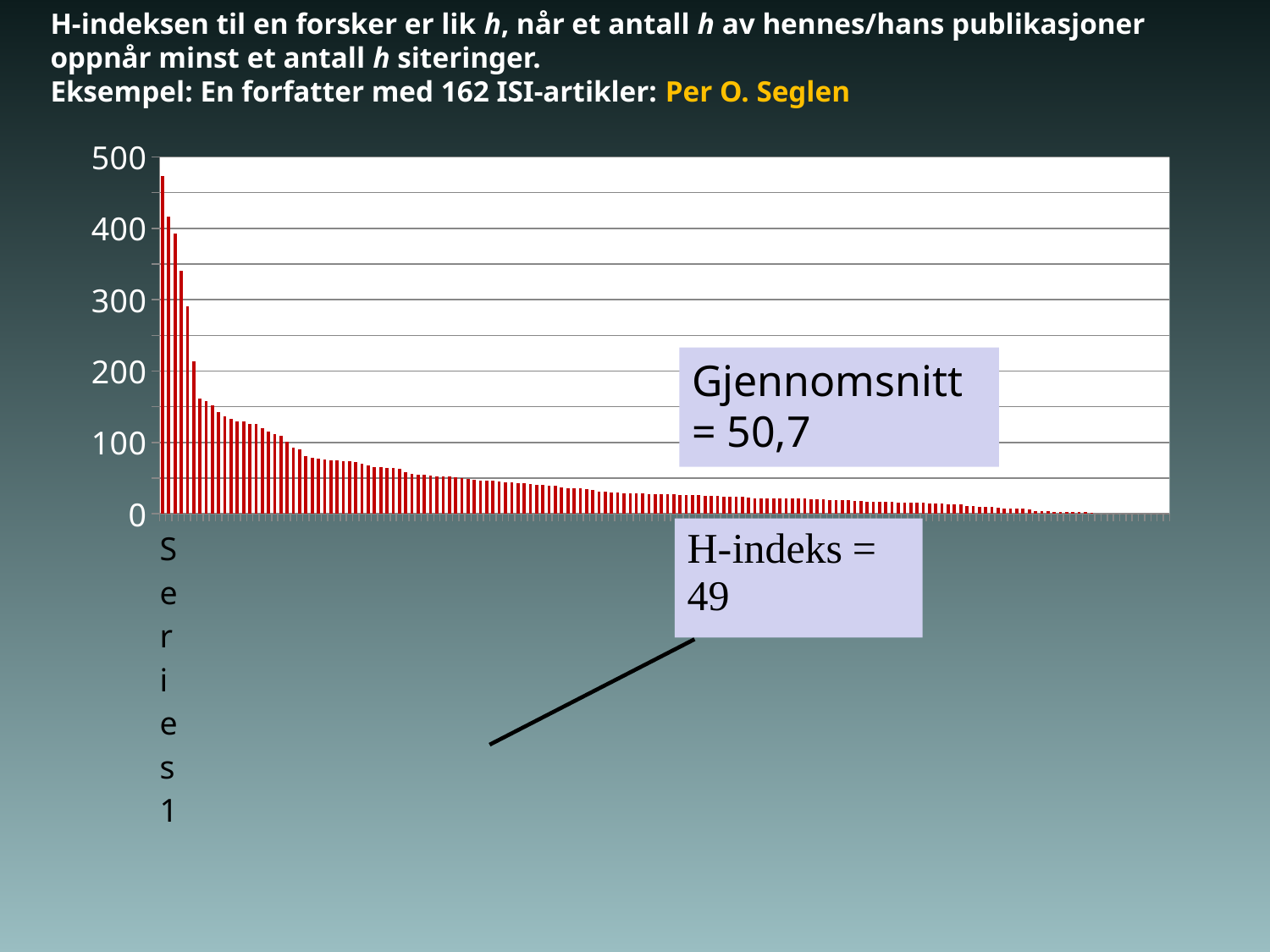
What H-index (H-indeks) value is stated on the slide? 49 Is the value of the rightmost bar greater or less than 100? less How many series does the legend list? 1 What is the highest value shown on the y axis? 500 Is the value of the tallest bar greater or less than 500? less Is the value of the tallest (leftmost) bar greater or less than 400? greater What kind of chart is shown on the slide? bar chart Do the bar values rise or fall from left to right along the x axis? fall According to the slide, how many ISI articles does the chart represent? 162 What average (Gjennomsnitt) value is stated in the text box on the chart? 50,7 Which is larger, the stated average (Gjennomsnitt) or the stated H-indeks? Gjennomsnitt What is the name of the series shown in the legend? Series1